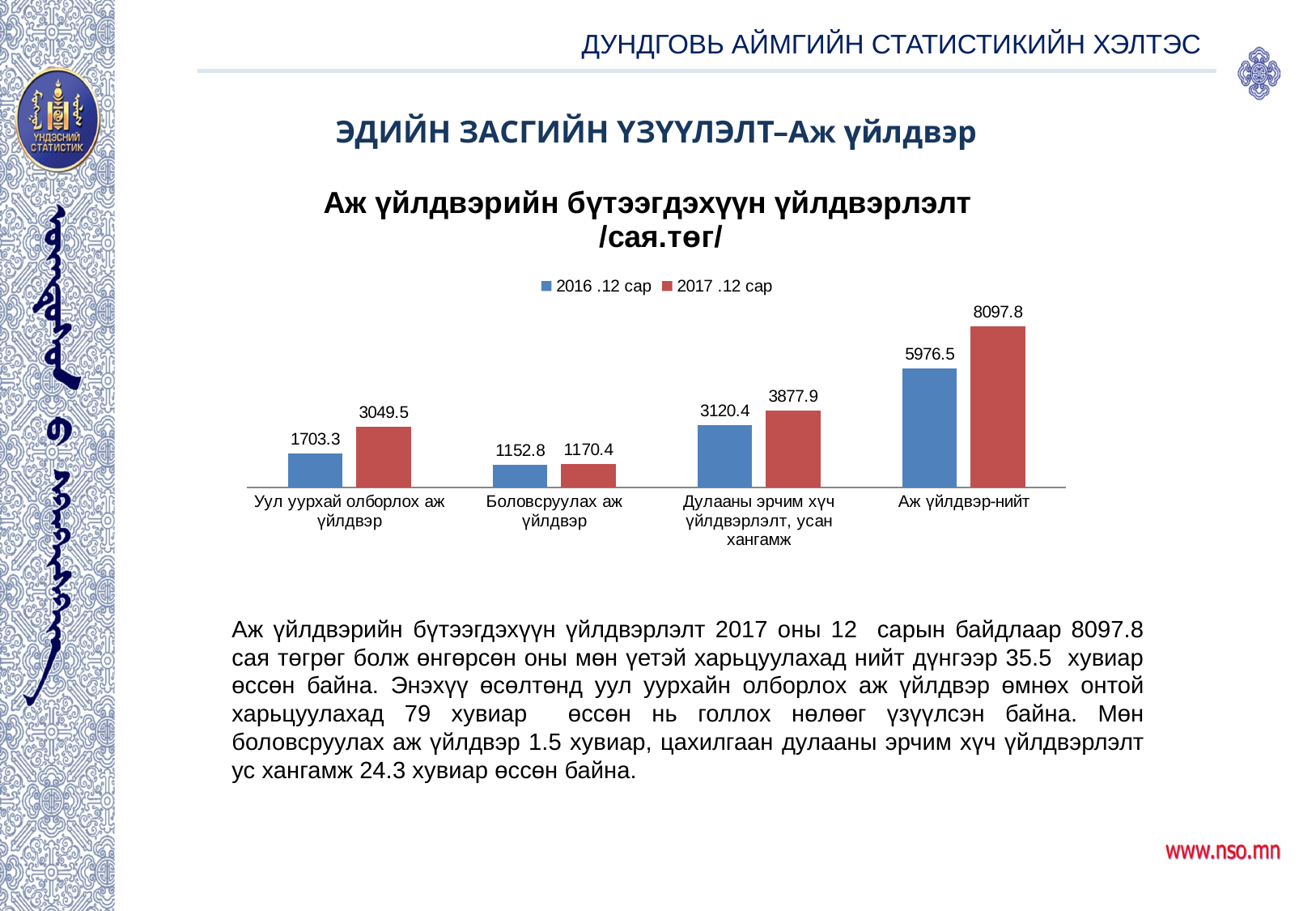
How many series does the legend list? 2 What is the value for Боловсруулах аж үйлдвэр in the 2016 .12 сар series? 1152.8 What kind of chart is shown on the slide? Bar chart Which category has the highest value in the 2017 .12 сар series? Аж үйлдвэр-нийт What is the difference between the 2017 .12 сар and 2016 .12 сар values for Уул уурхай олборлох аж үйлдвэр? 1346.2 What is the difference between the 2017 .12 сар and 2016 .12 сар values for Аж үйлдвэр-нийт? 2121.3 What is the value for Уул уурхай олборлох аж үйлдвэр in the 2017 .12 сар series? 3049.5 Which category has the lowest value in the 2016 .12 сар series? Боловсруулах аж үйлдвэр Which is larger for Дулааны эрчим хүч үйлдвэрлэлт, усан хангамж: the 2016 .12 сар value or the 2017 .12 сар value? 2017 .12 сар How many categories are shown on the x axis of the chart? 4 What is the value for Аж үйлдвэр-нийт in the 2017 .12 сар series? 8097.8 What is the value for Дулааны эрчим хүч үйлдвэрлэлт, усан хангамж in the 2016 .12 сар series? 3120.4